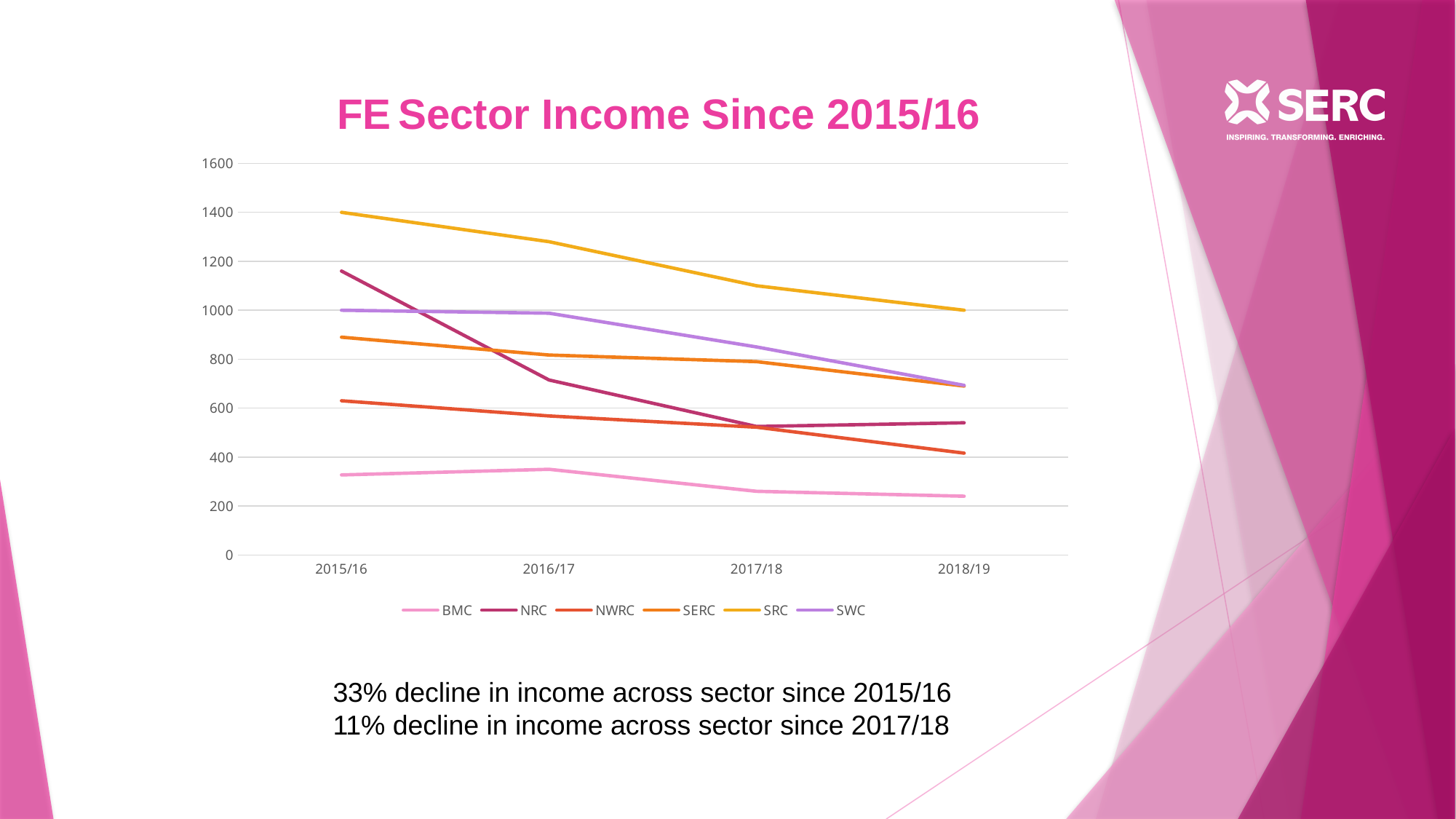
What is the title of the chart? FE Sector Income Since 2015/16 Is the value for NWRC in 2018/19 greater or less than 600? less Does the SRC line rise or fall from 2015/16 to 2018/19? fall Which college has the highest income in 2015/16? SRC Which college has the lowest income in 2018/19? BMC Is the value for NRC in 2015/16 greater or less than 1000? greater How many years are shown on the x axis? 4 What kind of chart is shown on the slide? line chart How many series does the legend list? 6 Which is larger in 2015/16, the value for NRC or the value for SWC? NRC Is the value for SERC in 2015/16 greater or less than 800? greater